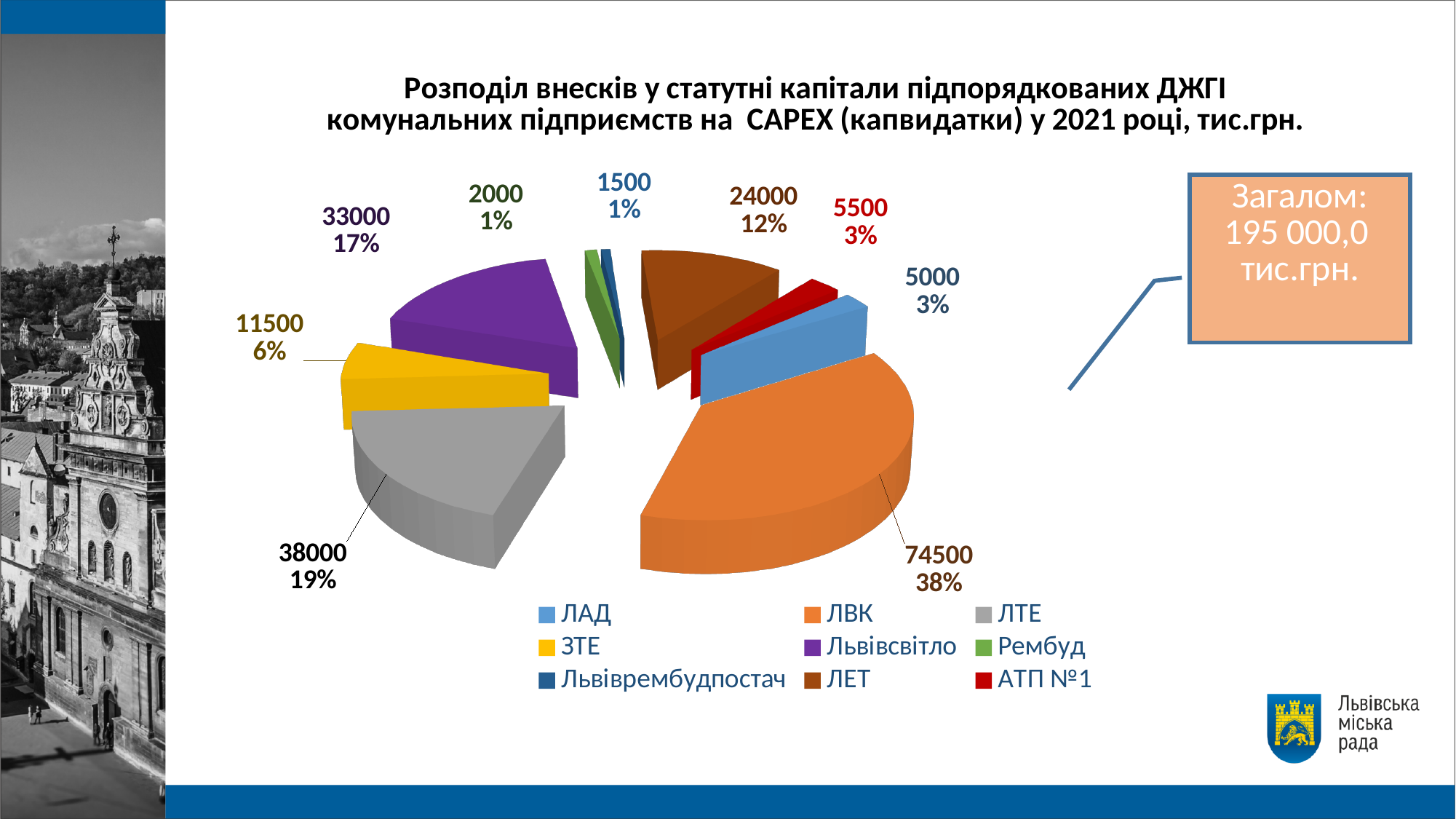
How many entries does the legend list? 9 What type of chart is shown on the slide? Pie chart Which category has the smallest value? Львіврембудпостач What share of the pie does ЛТЕ represent? 19% What is the value for ЛЕТ? 24000 Which is larger, the value for ЗТЕ or the value for АТП №1? ЗТЕ What is the value for ЛВК? 74500 What is the value for Львівсвітло? 33000 What is the difference between the values for ЛВК and ЛТЕ? 36500 What total amount is stated in the box next to the chart? 195 000,0 тис.грн. How many slices does the pie chart have? 9 Which category has the largest share of the pie? ЛВК